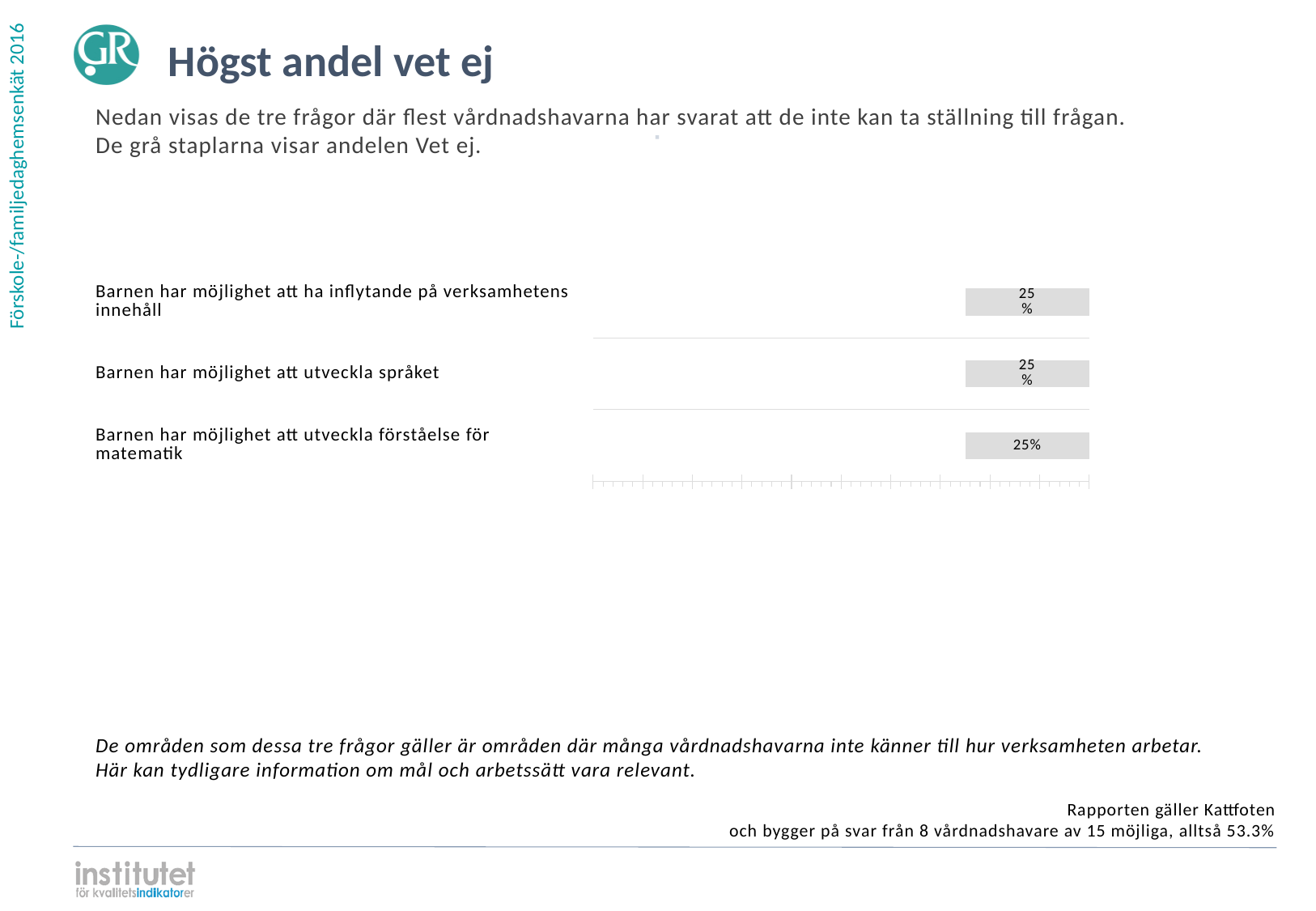
What is the value for "Barnen har möjlighet att ha inflytande på verksamhetens innehåll"? 25% How many categories are shown in the chart? 3 Are the bars in the chart horizontal or vertical? horizontal What is the difference between the value for "Barnen har möjlighet att utveckla språket" and the value for "Barnen har möjlighet att utveckla förståelse för matematik"? 0% What is the value for "Barnen har möjlighet att utveckla språket"? 25% What is the title of the slide containing the chart? Högst andel vet ej Do all three bars in the chart show the same value? Yes What colour are the bars in the chart? grey What kind of chart is shown on the slide? bar chart What is the value for "Barnen har möjlighet att utveckla förståelse för matematik"? 25%